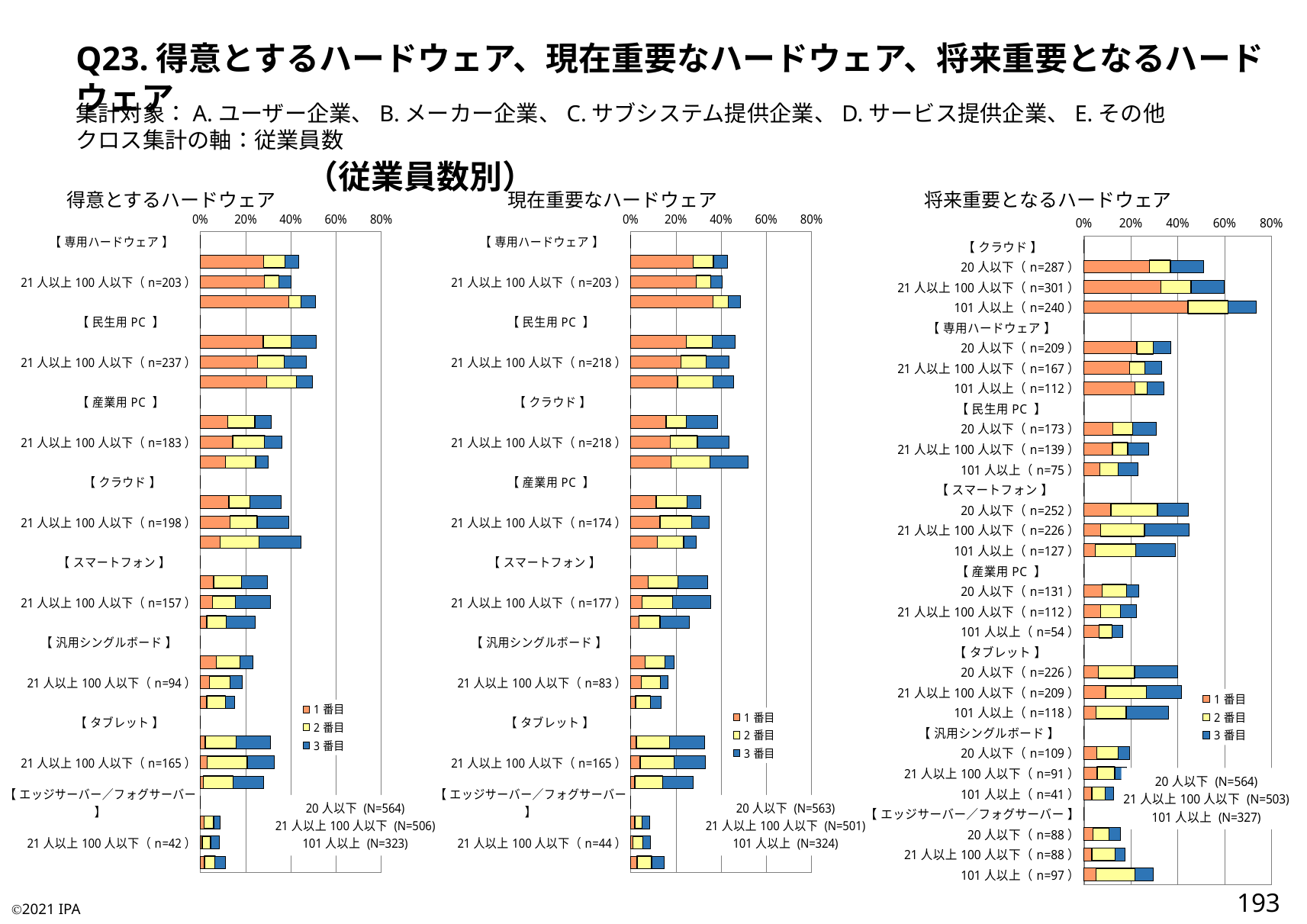
In the middle chart titled 現在重要なハードウェア, is the total bar for 汎用シングルボード 21人以上100人以下 (n=83) greater or less than 20%? less What kind of chart is the left chart titled 得意とするハードウェア? stacked bar chart In the middle chart titled 現在重要なハードウェア, what are the legend entries? 1番目, 2番目, 3番目 In the right chart titled 将来重要となるハードウェア, which bar is the longest overall? クラウド 101人以上 (n=240) In the right chart titled 将来重要となるハードウェア, how many series does the legend list? 3 In the left chart titled 得意とするハードウェア, is the total bar for the 101人以上 row under 専用ハードウェア greater or less than 40%? greater In the right chart titled 将来重要となるハードウェア, which total bar is longer: クラウド 101人以上 (n=240) or 専用ハードウェア 101人以上 (n=112)? クラウド 101人以上 (n=240) In the right chart titled 将来重要となるハードウェア, is the total bar for クラウド 101人以上 (n=240) greater or less than 60%? greater In the right chart titled 将来重要となるハードウェア, how many hardware categories (bracketed group headings) are shown? 8